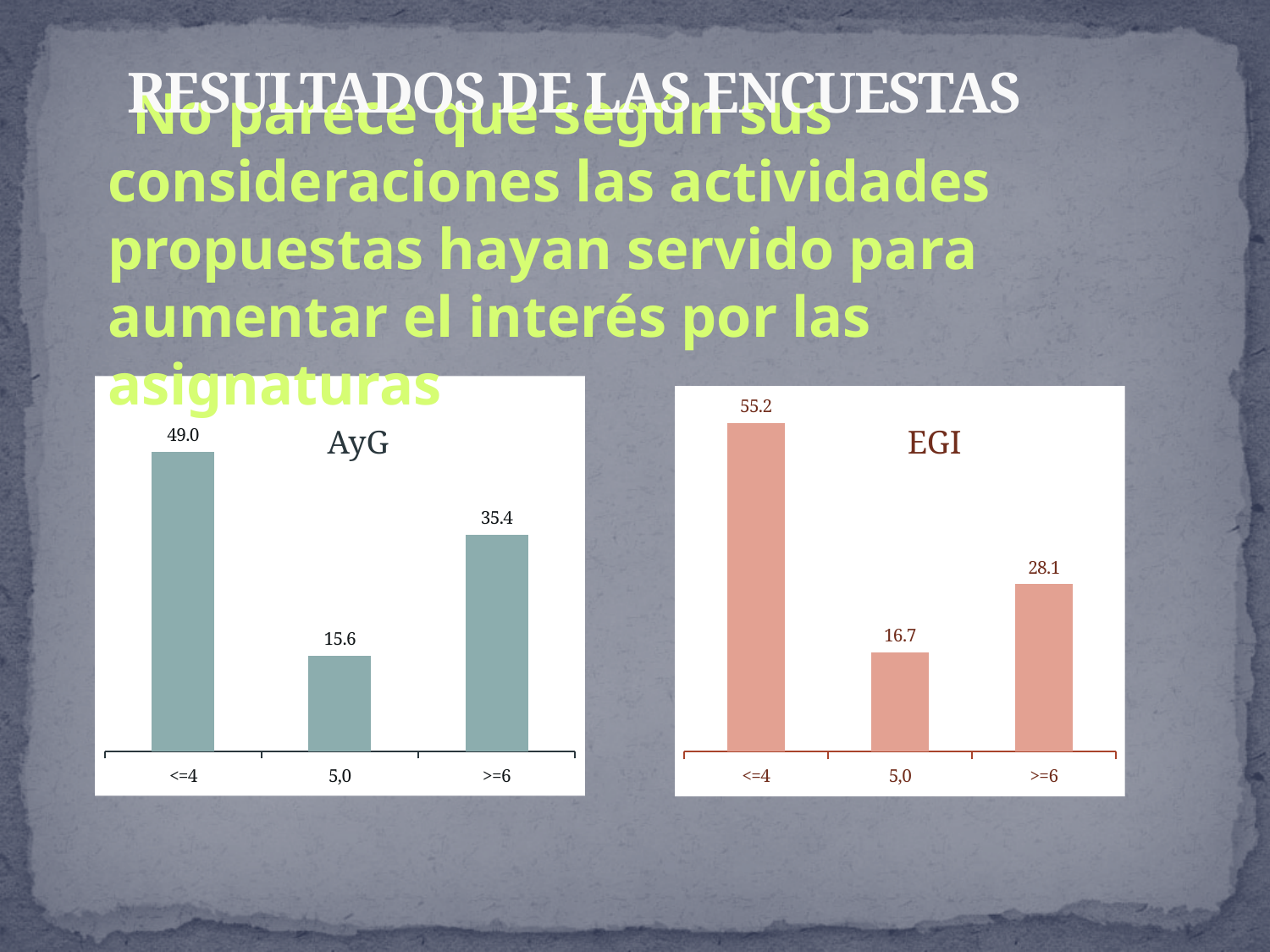
In the AyG chart, what is the value for the <=4 category? 49.0 In the EGI chart, what is the value for the >=6 category? 28.1 Which is larger: the value for >=6 in the AyG chart or the value for >=6 in the EGI chart? AyG In the AyG chart, what is the total of the three values shown? 100.0 In the EGI chart, what is the difference between the values for <=4 and 5,0? 38.5 In the EGI chart, which category has the lowest value? 5,0 In the AyG chart, how many categories are shown? 3 In the AyG chart, what is the difference between the values for <=4 and >=6? 13.6 In the AyG chart, which category has the highest value? <=4 What type of chart is the EGI chart? bar chart In the EGI chart, what is the value for the 5,0 category? 16.7 What is the title of the chart on the right side of the slide? EGI